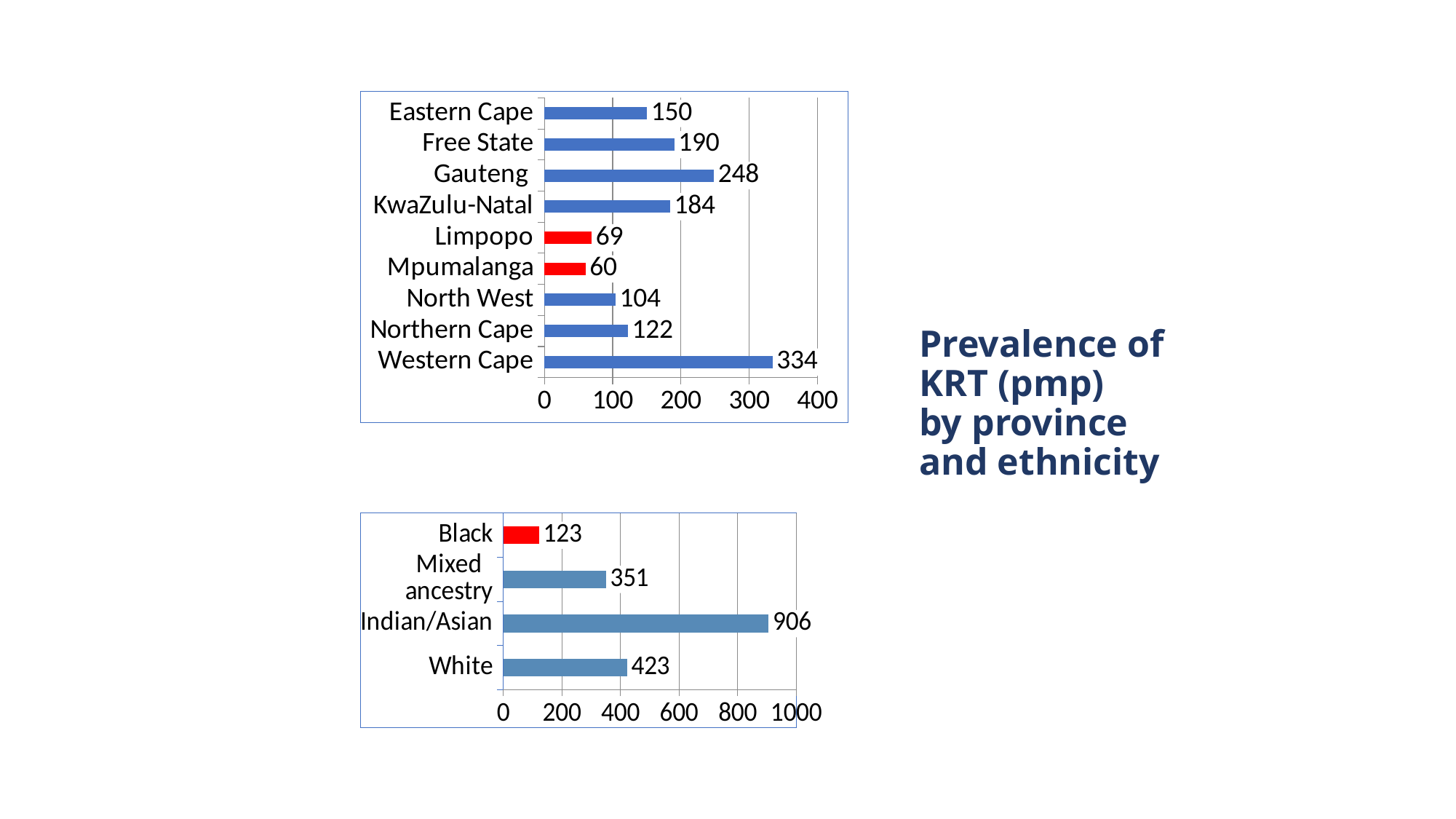
In the top chart (by province), what is the value for Mpumalanga? 60 In the top chart (by province), which is larger, Free State or KwaZulu-Natal? Free State In the bottom chart (by ethnicity), which group has the lowest value? Black In the top chart (by province), which bars are coloured red? Limpopo and Mpumalanga What kind of chart is the bottom chart (by ethnicity)? Bar chart In the top chart (by province), which province has the highest value? Western Cape In the top chart (by province), how many provinces are shown? 9 In the top chart (by province), which province has the lowest value? Mpumalanga In the bottom chart (by ethnicity), what is the difference between White and Mixed ancestry? 72 In the top chart (by province), what is the difference between Western Cape and Eastern Cape? 184 In the top chart (by province), what is the value for Gauteng? 248 In the bottom chart (by ethnicity), what is the value for Indian/Asian? 906